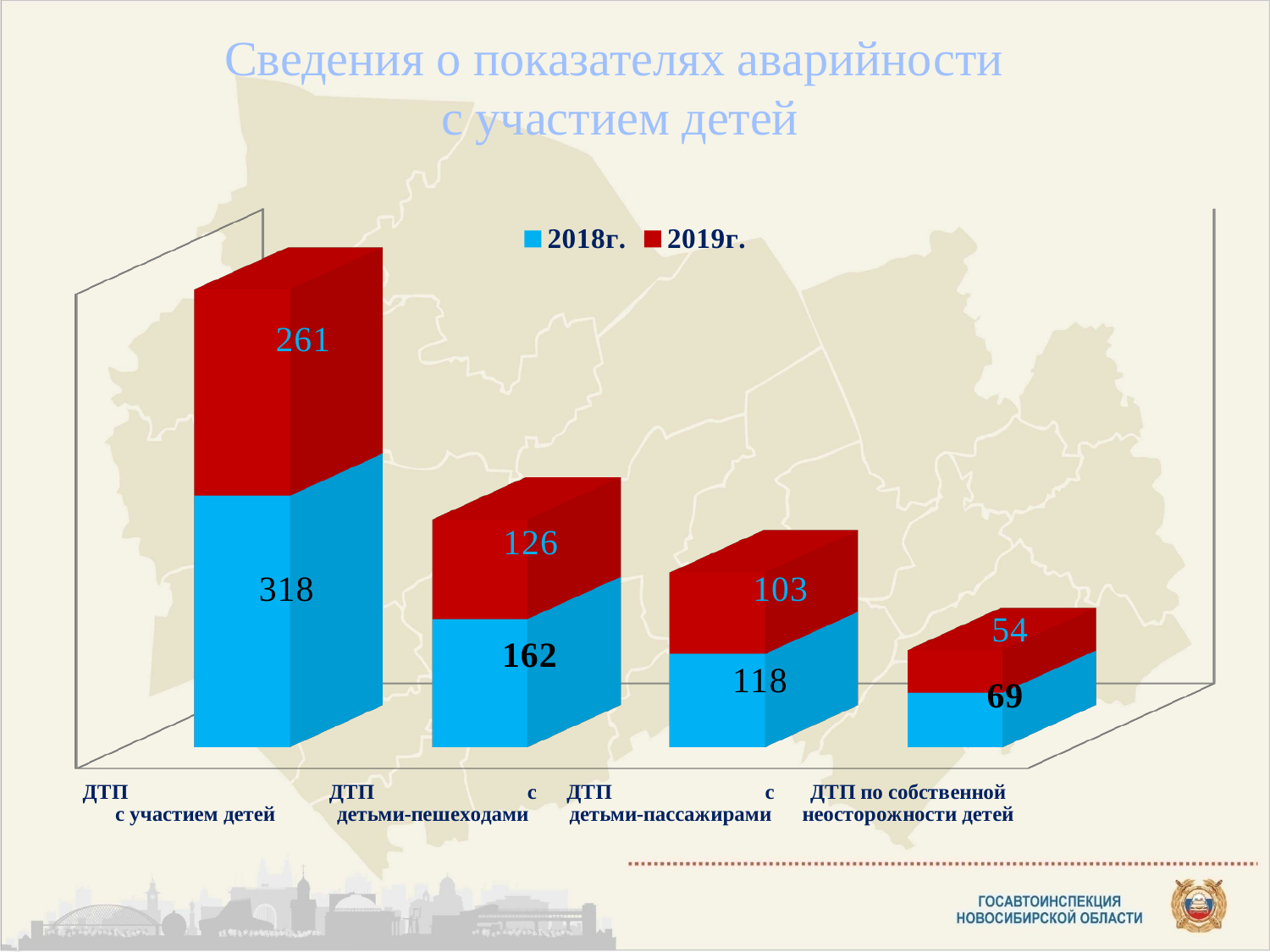
How many categories are shown on the x axis? 4 Which category has the lowest 2018г. value? ДТП по собственной неосторожности детей What is the 2019г. value for ДТП с детьми-пешеходами? 126 How many series does the legend list? 2 What type of chart is shown on the slide? bar chart What is the 2018г. value for ДТП с детьми-пассажирами? 118 What is the 2019г. value for ДТП по собственной неосторожности детей? 54 What is the total of the stacked bar for ДТП по собственной неосторожности детей? 123 What is the difference between the 2018г. and 2019г. values for ДТП с детьми-пешеходами? 36 Which is larger for ДТП с детьми-пассажирами: the 2018г. value or the 2019г. value? 2018г. What is the 2018г. value for ДТП с участием детей? 318 What is the 2019г. value for ДТП с участием детей? 261